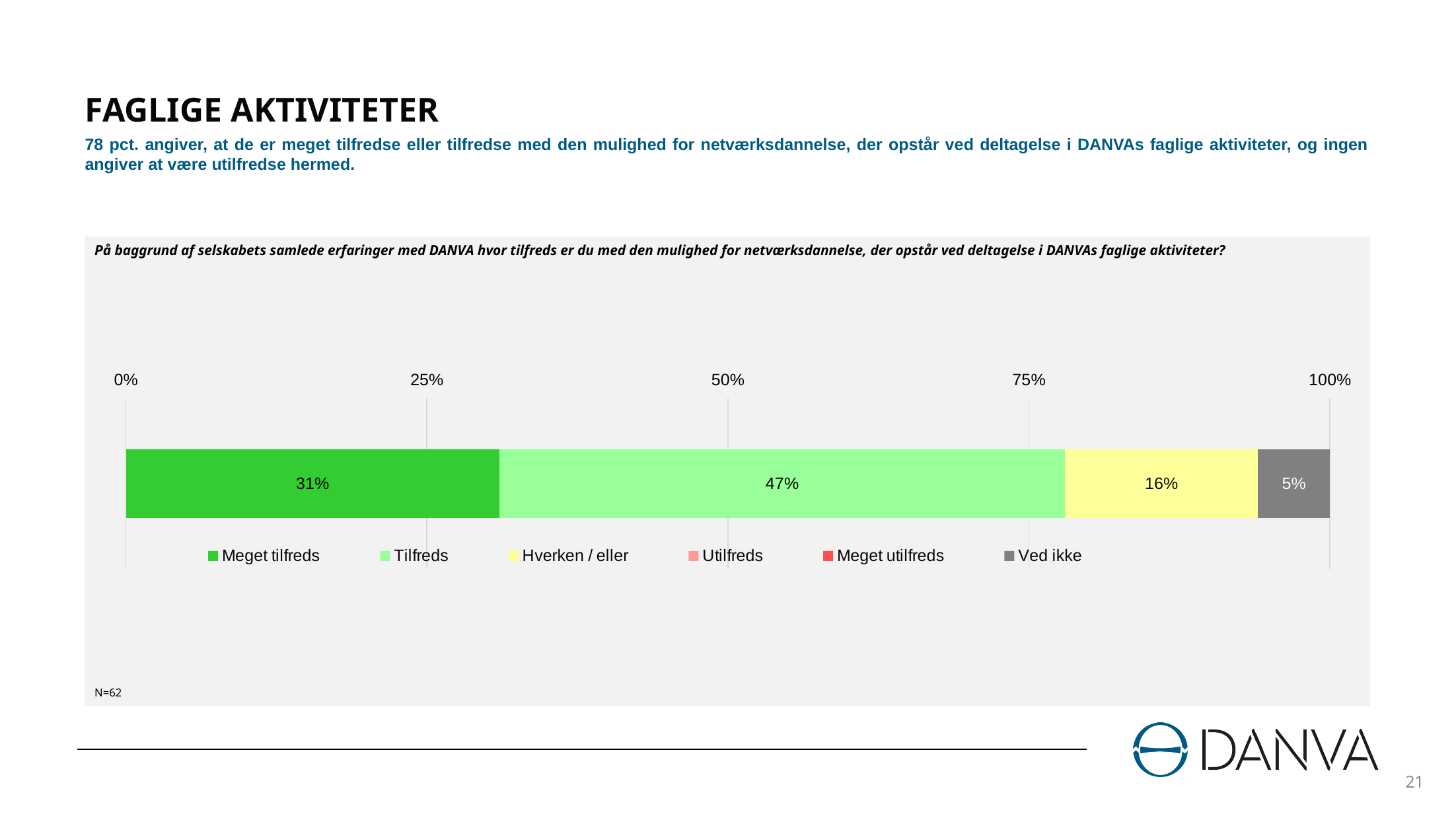
What kind of chart is shown on the slide? Stacked bar chart What percentage of respondents answered "Meget tilfreds"? 31% Which response category has the largest share of the bar? Tilfreds How many series does the legend list? 6 What is the sample size (N) stated below the chart? N=62 What percentage of respondents answered "Ved ikke"? 5% Which is larger, the share for "Hverken / eller" or the share for "Ved ikke"? Hverken / eller Which of the labelled segments has the smallest share? Ved ikke What percentage of respondents answered "Hverken / eller"? 16% What is the combined share of "Meget tilfreds" and "Tilfreds"? 78% What is the difference in percentage points between "Tilfreds" and "Meget tilfreds"? 16 What percentage of respondents answered "Tilfreds"? 47%